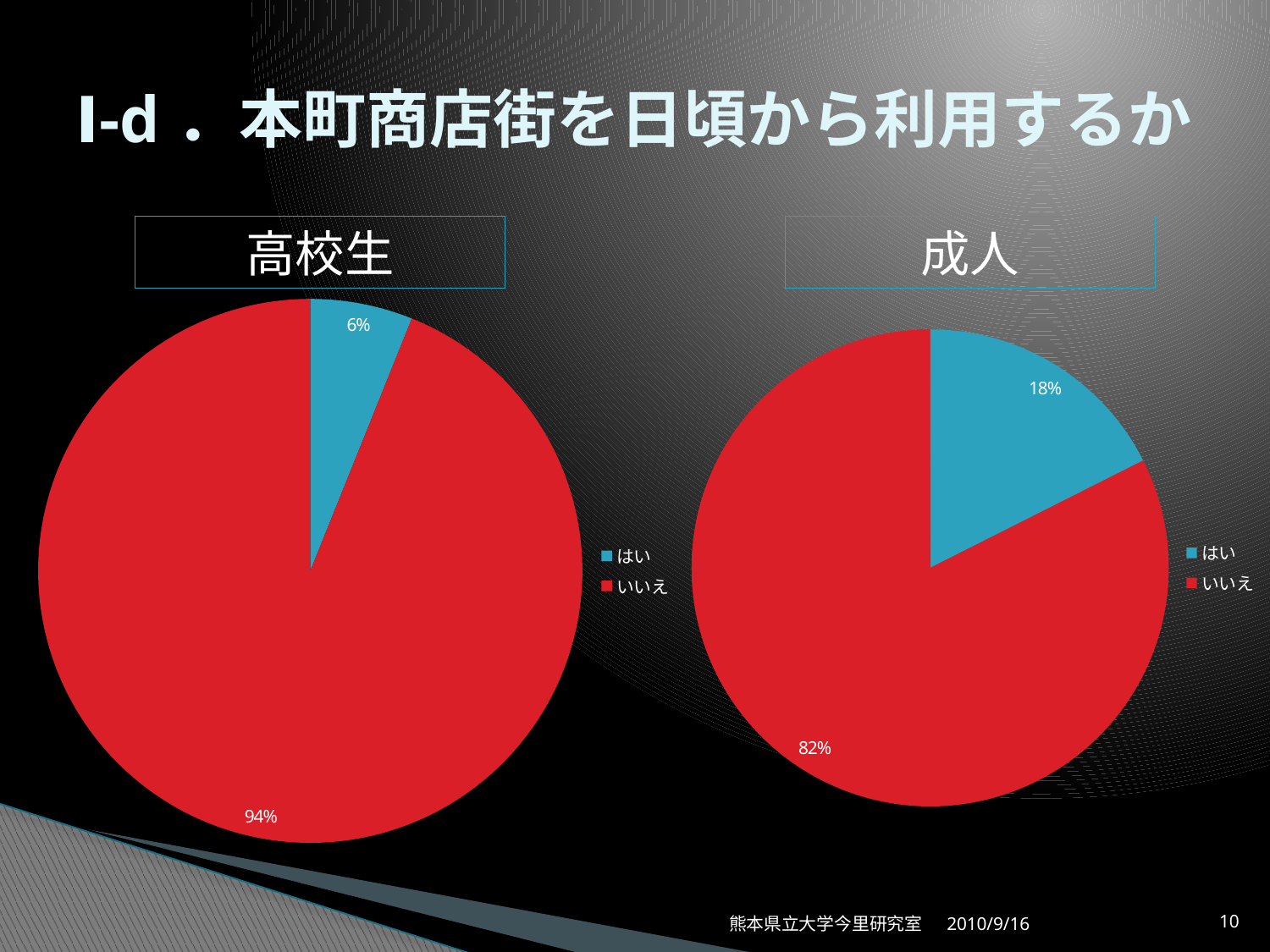
In the 成人 pie chart, what colour is the いいえ slice? red In the 成人 pie chart, what percentage is shown for はい? 18% In the 高校生 pie chart, what percentage is shown for いいえ? 94% How many slices does the 成人 pie chart have? 2 What is the difference between the いいえ and はい percentages in the 成人 pie chart? 64% Which is larger: the はい share in the 高校生 chart or the はい share in the 成人 chart? 成人 What type of chart is used for the 高校生 data? pie chart How many entries does the legend of the 高校生 chart list? 2 In the 高校生 pie chart, what percentage is shown for はい? 6% In the 成人 pie chart, which category has the smallest slice? はい In the 高校生 pie chart, which category has the largest slice? いいえ In the 成人 pie chart, what percentage is shown for いいえ? 82%